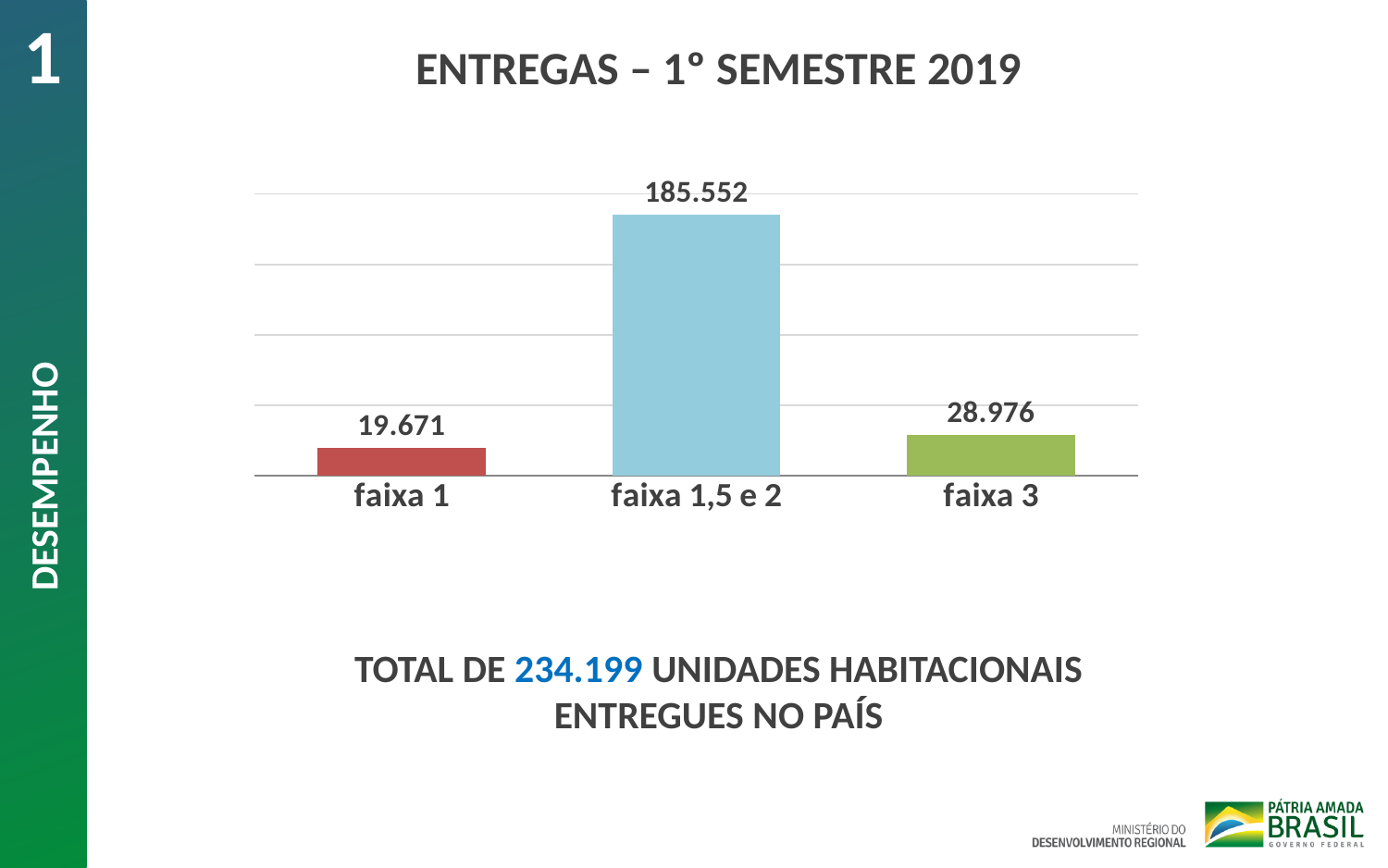
What is the value for faixa 1,5 e 2? 185.552 Which category has the highest value? faixa 1,5 e 2 What is the value for faixa 1? 19.671 What is the title of the chart? ENTREGAS – 1° SEMESTRE 2019 How many categories are shown in the chart? 3 Which is larger, the value for faixa 3 or the value for faixa 1? faixa 3 What is the difference between the values for faixa 1,5 e 2 and faixa 1? 165.881 What is the difference between the values for faixa 3 and faixa 1? 9.305 What is the total of the three values shown in the chart? 234.199 Which category has the lowest value? faixa 1 What is the value for faixa 3? 28.976 What kind of chart is shown on the slide? bar chart